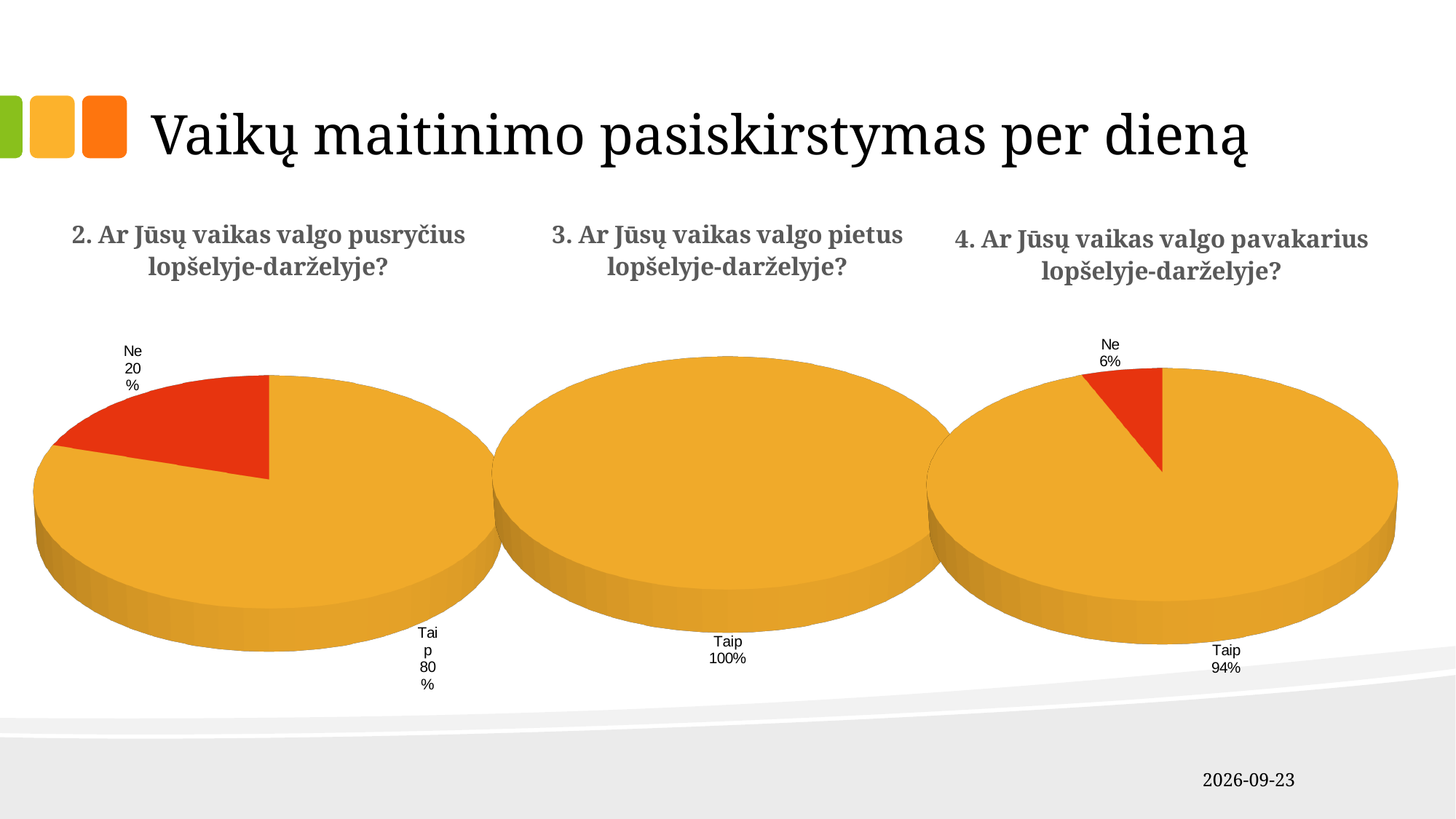
How many pie charts are shown on the slide? 3 In the left chart ("2. Ar Jūsų vaikas valgo pusryčius lopšelyje-darželyje?"), what is the value for "Ne"? 20% In the right chart ("4. Ar Jūsų vaikas valgo pavakarius lopšelyje-darželyje?"), what is the value for "Taip"? 94% In the left chart ("2. Ar Jūsų vaikas valgo pusryčius lopšelyje-darželyje?"), what share of the pie is "Taip"? 80% In the right chart ("4. Ar Jūsų vaikas valgo pavakarius lopšelyje-darželyje?"), what is the value for "Ne"? 6% In the left chart ("2. Ar Jūsų vaikas valgo pusryčius lopšelyje-darželyje?"), which slice is the largest? Taip In the left chart ("2. Ar Jūsų vaikas valgo pusryčius lopšelyje-darželyje?"), what is the difference between the "Taip" and "Ne" values? 60% Which is larger: the "Ne" value in the left chart (pusryčius) or the "Ne" value in the right chart (pavakarius)? The left chart (pusryčius), 20% In the middle chart ("3. Ar Jūsų vaikas valgo pietus lopšelyje-darželyje?"), what share of the pie is "Taip"? 100% What kind of chart is used for the three charts on the slide? Pie chart In the right chart ("4. Ar Jūsų vaikas valgo pavakarius lopšelyje-darželyje?"), which slice is the smallest? Ne How many slices does the middle chart ("3. Ar Jūsų vaikas valgo pietus lopšelyje-darželyje?") show? 1